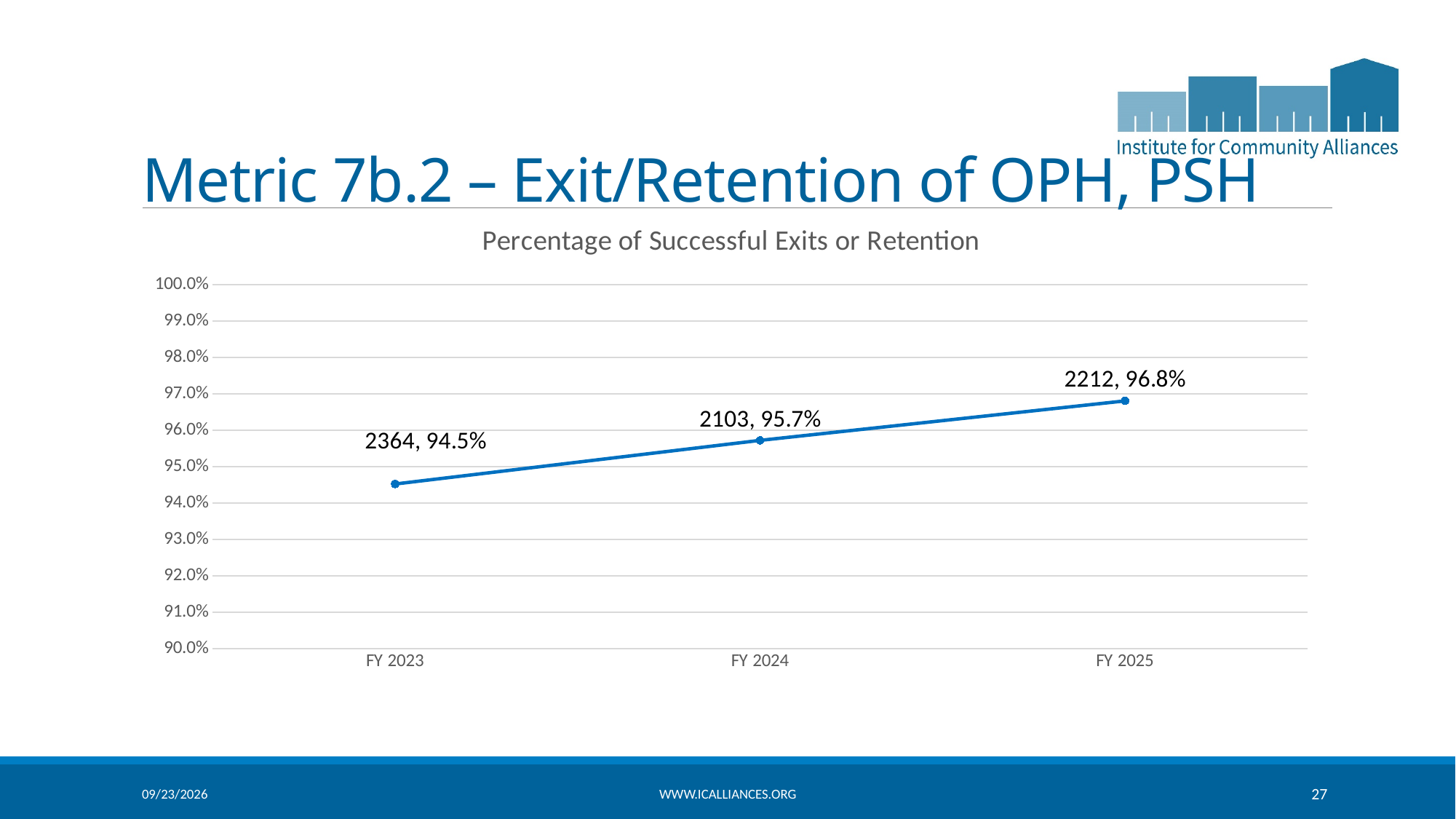
What percentage of successful exits or retention is shown for FY 2025? 96.8% Which fiscal year has the lowest percentage of successful exits or retention? FY 2023 What kind of chart is shown on the slide? line chart What count is printed in the data label for FY 2025? 2212 Does the percentage rise or fall from FY 2023 to FY 2025? rise What is the difference in percentage points between FY 2025 and FY 2023? 2.3 Which fiscal year has the highest percentage of successful exits or retention? FY 2025 What count is printed in the data label for FY 2023? 2364 Is the percentage for FY 2024 greater or less than 95.0%? greater What percentage of successful exits or retention is shown for FY 2024? 95.7% How many fiscal years are plotted on the chart? 3 What percentage of successful exits or retention is shown for FY 2023? 94.5%